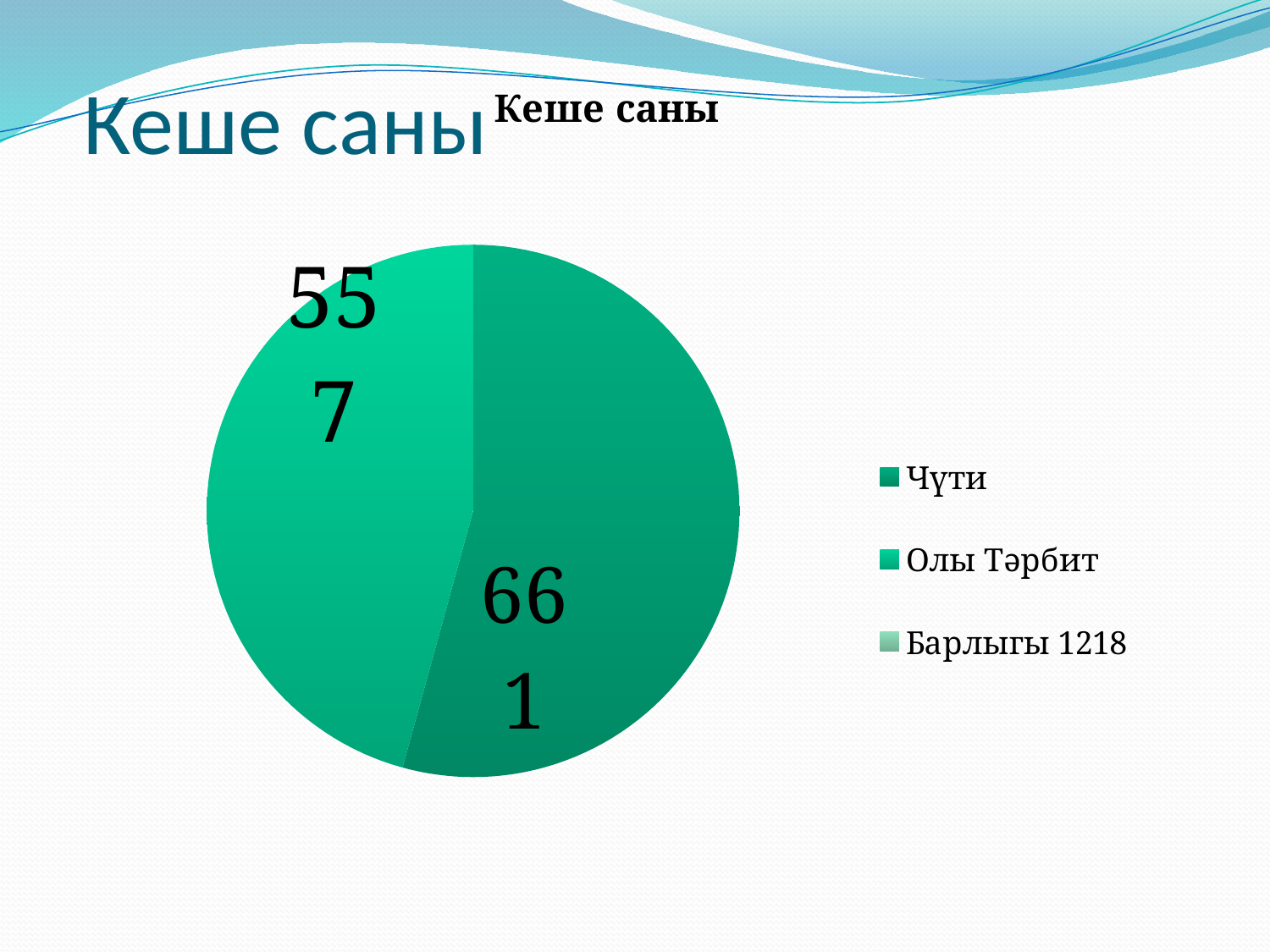
What is the sum of the two plotted slice values (661 and 557)? 1218 What is the third legend entry of the chart? Барлыгы 1218 What is the difference between the Чүти value and the Олы Тәрбит value? 104 How many entries does the chart legend list? 3 Which of the two plotted slices is the smallest? Олы Тәрбит How many slices are visibly plotted in the pie chart? 2 What value is shown for the Чүти slice of the pie chart? 661 What kind of chart is shown on the slide? Pie chart Which is larger, the value for Чүти or the value for Олы Тәрбит? Чүти What is the title of the chart? Кеше саны What value is shown for the Олы Тәрбит slice of the pie chart? 557 Which slice of the pie chart is the largest? Чүти